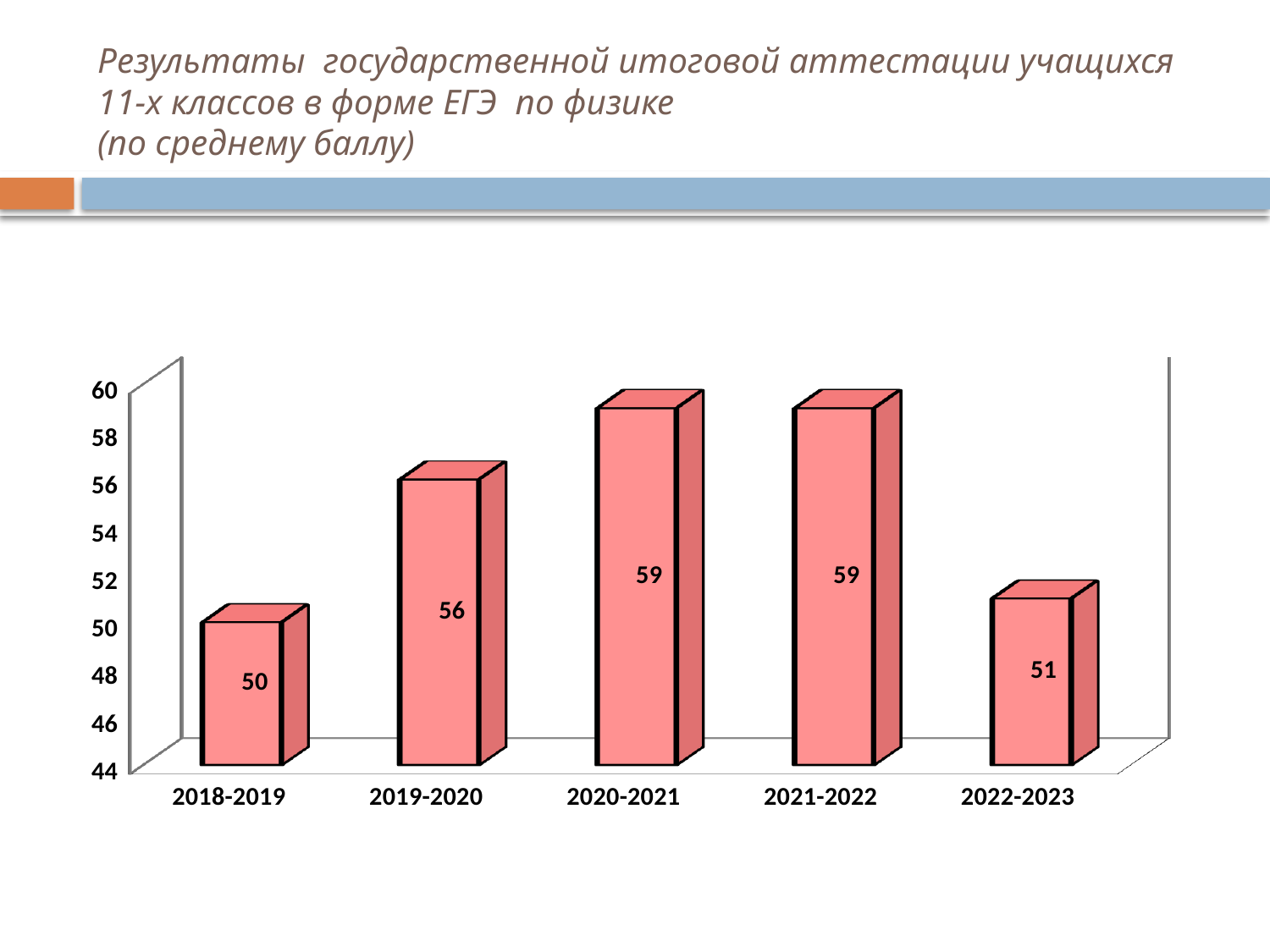
What is the difference between the values for 2020-2021 and 2018-2019? 9 Which category has the lowest value? 2018-2019 Which is larger, the value for 2019-2020 or the value for 2022-2023? 2019-2020 What is the highest value shown on the chart? 59 What kind of chart is shown on the slide? bar chart What is the difference between the values for 2019-2020 and 2022-2023? 5 What is the value for 2018-2019? 50 What is the value for 2022-2023? 51 Do the values rise or fall from 2021-2022 to 2022-2023? fall What is the value for 2019-2020? 56 How many categories are shown on the x axis? 5 Is the value for 2021-2022 greater or less than 54? greater